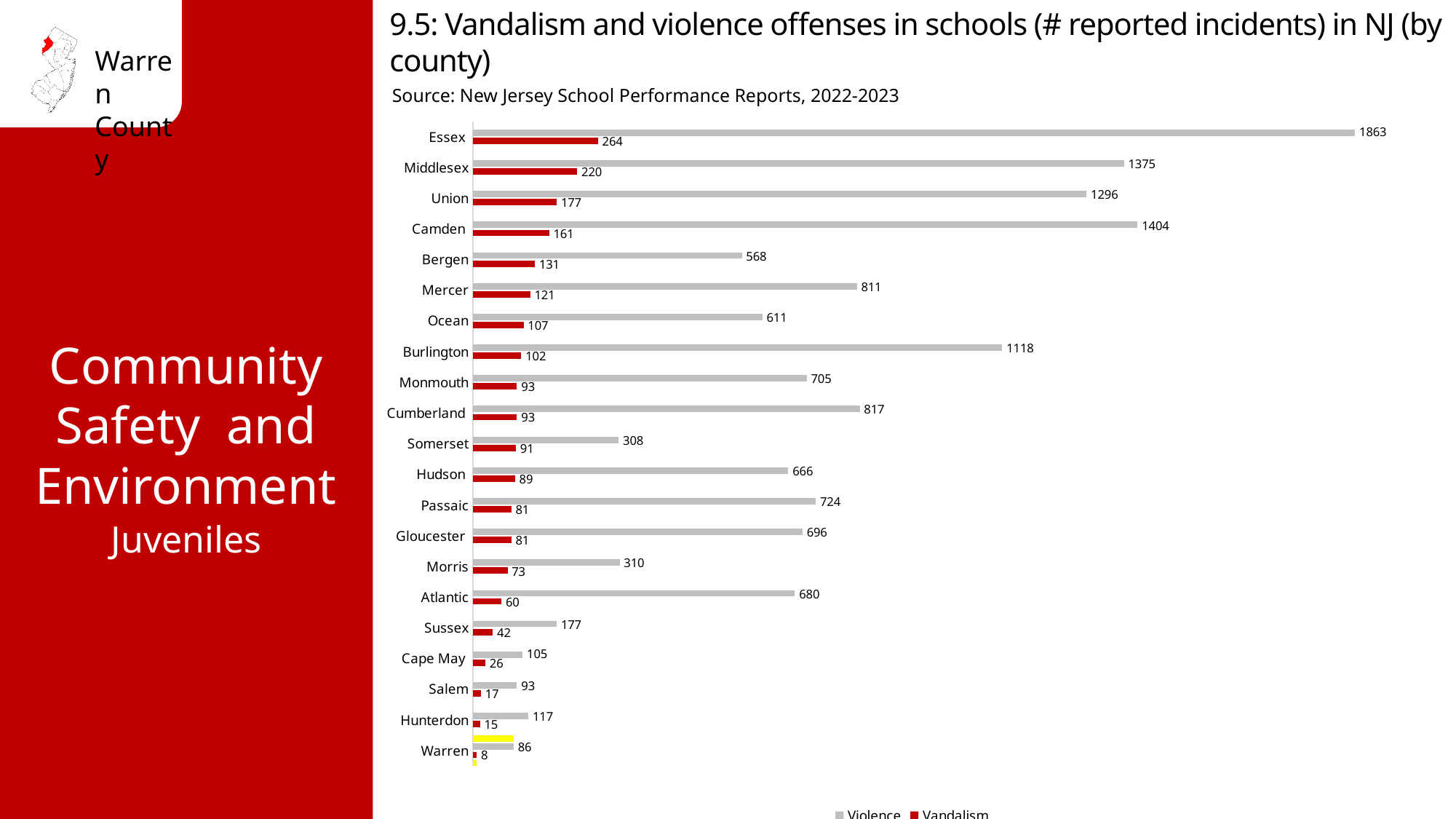
What is the number of reported violence incidents in Camden County? 1404 Which county has more reported violence incidents, Camden or Union? Camden What is the difference between the violence incidents in Essex and Middlesex? 488 How many series does the legend list? 2 Which county has the highest number of reported violence incidents? Essex Which county's bars are highlighted in yellow? Warren What is the number of reported vandalism incidents in Warren County? 8 How many counties are shown in the chart? 21 What is the number of reported violence incidents in Essex County? 1863 What is the combined total of violence and vandalism incidents for Warren County? 94 What kind of chart is shown on the slide? Bar chart Which county has the lowest number of reported vandalism incidents? Warren